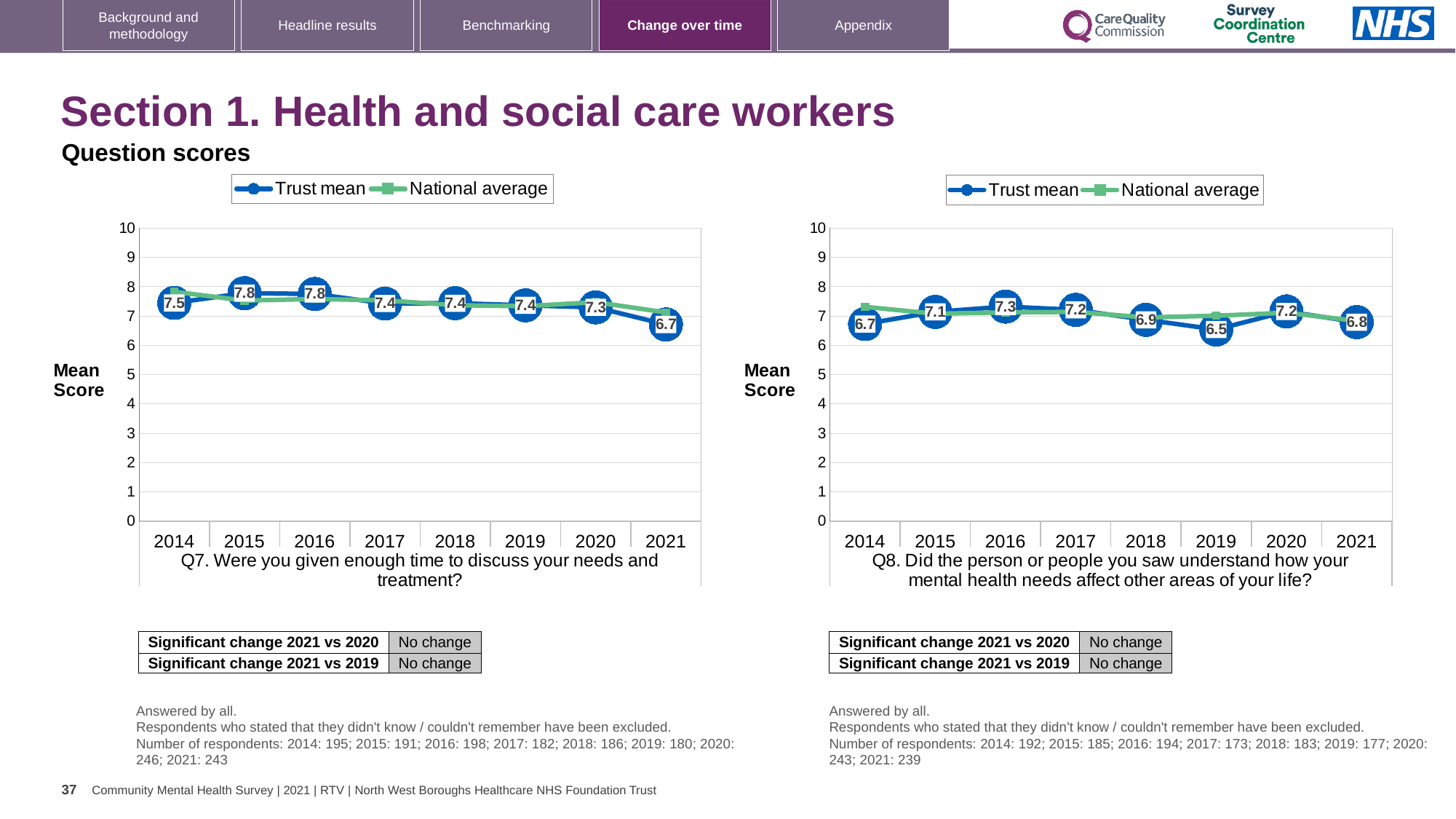
How many series does the legend of the Q8 chart on the right list? 2 In the Q8 chart on the right, what is the Trust mean score for 2019? 6.5 In the Q8 chart on the right, which year has the lowest Trust mean score? 2019 In the Q8 chart on the right, what is the Trust mean score for 2016? 7.3 In the Q8 chart on the right, which year has the highest Trust mean score? 2016 How many years are plotted on the x axis of the Q7 chart on the left? 8 In the Q7 chart on the left, what is the difference between the Trust mean scores for 2020 and 2021? 0.6 In the Q7 chart on the left, what is the Trust mean score for 2015? 7.8 What type of chart is the Q7 chart on the left? Line chart In the Q8 chart on the right, is the Trust mean score higher in 2014 or in 2015? 2015 In the Q7 chart on the left, what is the Trust mean score for 2021? 6.7 In the Q7 chart on the left, which year has the lowest Trust mean score? 2021